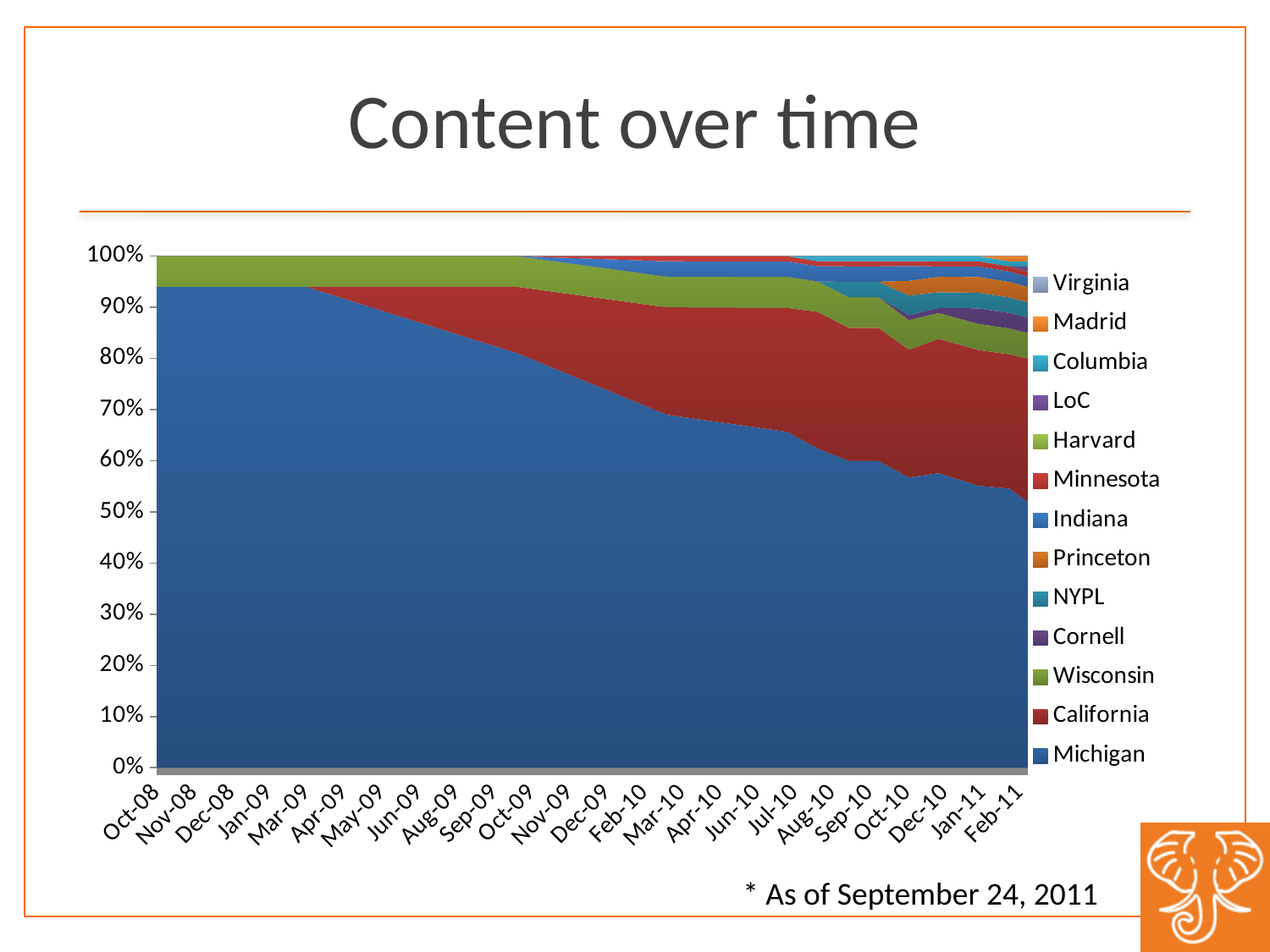
How many series does the legend list? 13 Is Michigan's share in Oct-08 greater or less than 90%? greater Which series has the largest share of content in Feb-11? Michigan In Feb-11, which has the larger share: Michigan or California? Michigan Is Michigan's share in Mar-10 greater or less than 60%? greater What kind of chart is shown on the slide? Stacked area chart Which series is listed first in the legend? Virginia Is Michigan's share in Feb-11 greater or less than 60%? less What is the title of the chart? Content over time How many time points are shown along the x axis? 24 Does Michigan's share of content rise or fall from Oct-08 to Feb-11? Fall Which series has the largest share of content in Oct-08? Michigan